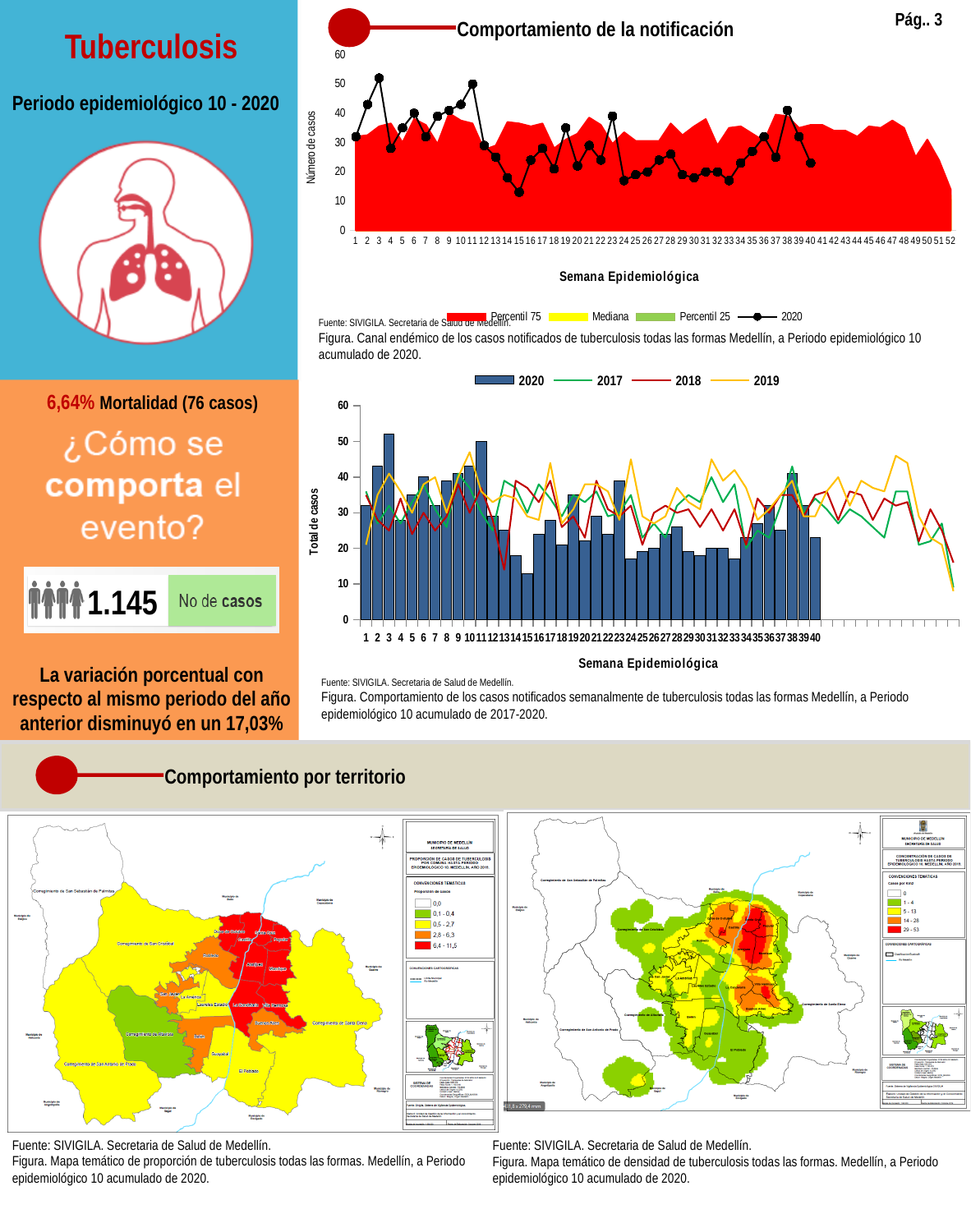
In the top 'Comportamiento de la notificación' chart, which epidemiological week has the lowest value on the 2020 line? 15 What is the x-axis title of the top 'Comportamiento de la notificación' chart? Semana Epidemiológica What type of chart is the 'Comportamiento de la notificación' chart at the top of the slide? area chart with a line (area and line chart) In the top 'Comportamiento de la notificación' chart, is the 2020 value for week 11 greater or less than 40? greater In the second chart (2017-2020 weekly cases), is the 2020 bar for week 24 greater or less than 20? less In the top 'Comportamiento de la notificación' chart, does the 2020 line rise or fall from week 11 to week 15? fall How many entries does the legend of the top 'Comportamiento de la notificación' chart list? 4 In the second chart (2017-2020 weekly cases), is the 2020 bar for week 3 greater or less than 40? greater How many series does the legend of the second chart (2017-2020 weekly cases) list? 4 In the second chart (2017-2020 weekly cases), which week has the lowest 2020 bar? 15 In the second chart (2017-2020 weekly cases), which series is drawn as bars? 2020